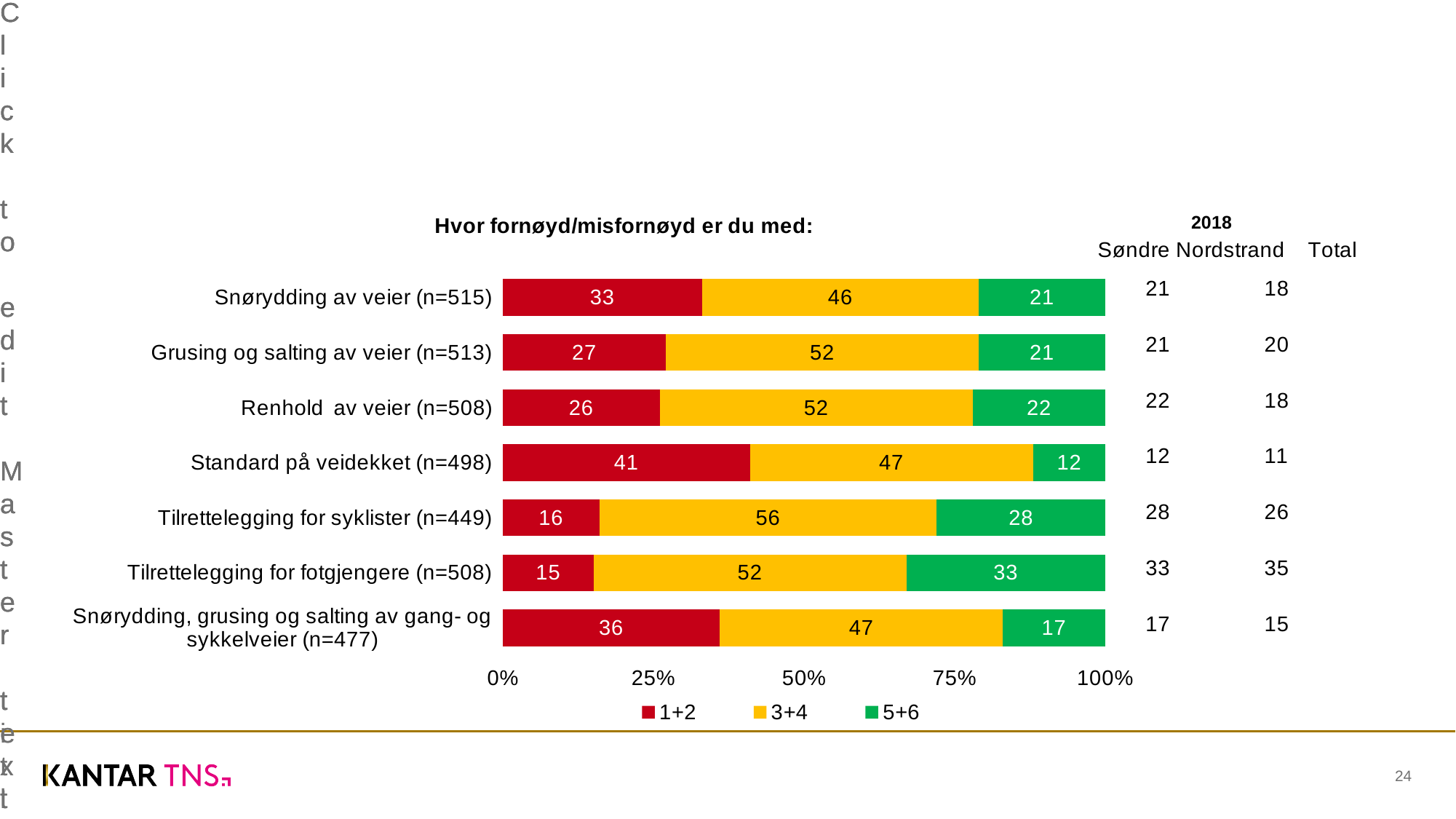
What is the value of the 1+2 series for Standard på veidekket (n=498)? 41 Which category has the lowest value for the 5+6 series? Standard på veidekket (n=498) How many categories are shown in the chart? 7 What is the value of the 3+4 series for Tilrettelegging for syklister (n=449)? 56 Which is larger: the 5+6 value for Tilrettelegging for syklister (n=449) or the 5+6 value for Renhold av veier (n=508)? Tilrettelegging for syklister (n=449) What is the value of the 5+6 series for Tilrettelegging for fotgjengere (n=508)? 33 What is the title of the chart? Hvor fornøyd/misfornøyd er du med: Which category has the highest value for the 1+2 series? Standard på veidekket (n=498) What is the difference between the 1+2 values for Snørydding av veier (n=515) and Grusing og salting av veier (n=513)? 6 What kind of chart is shown on the slide? Stacked bar chart What is the total of the stacked bar for Snørydding, grusing og salting av gang- og sykkelveier (n=477)? 100 How many series does the legend list? 3